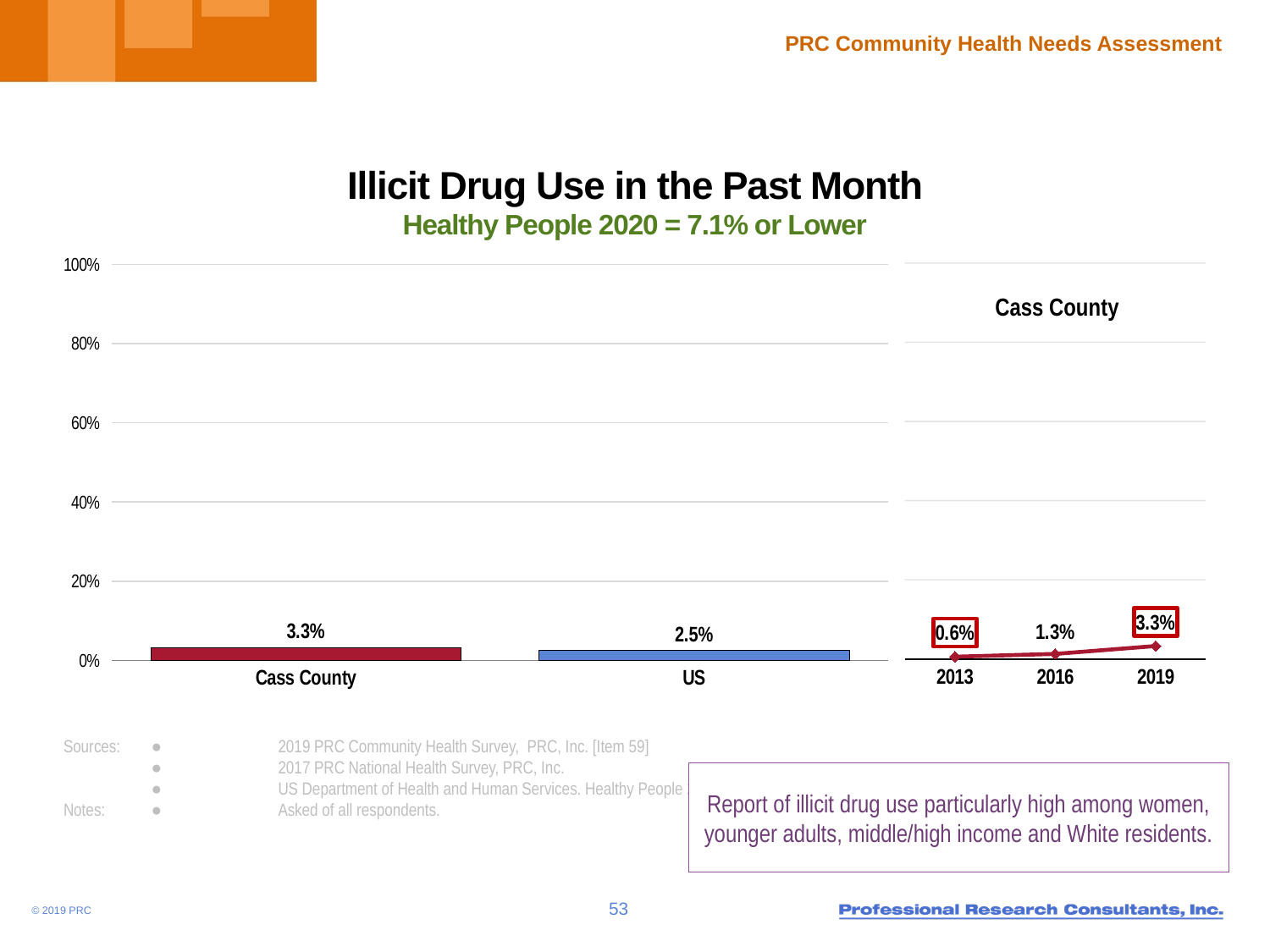
What kind of chart is the chart on the left? bar chart In the Cass County trend chart on the right, what is the difference between the 2019 and 2013 values? 2.7% In the bar chart on the left, what is the difference between the Cass County and US values? 0.8% In the bar chart on the left, what is the value for Cass County? 3.3% In the Cass County trend chart on the right, what is the value for 2013? 0.6% In the Cass County trend chart on the right, what is the value for 2016? 1.3% In the Cass County trend chart on the right, which year has the highest value? 2019 In the Cass County trend chart on the right, do the values rise or fall from 2013 to 2019? rise What is the Healthy People 2020 target shown in the chart subtitle? 7.1% or Lower In the bar chart on the left, how many categories are shown? 2 In the bar chart on the left, which category has the higher value, Cass County or US? Cass County In the bar chart on the left, what is the value for US? 2.5%